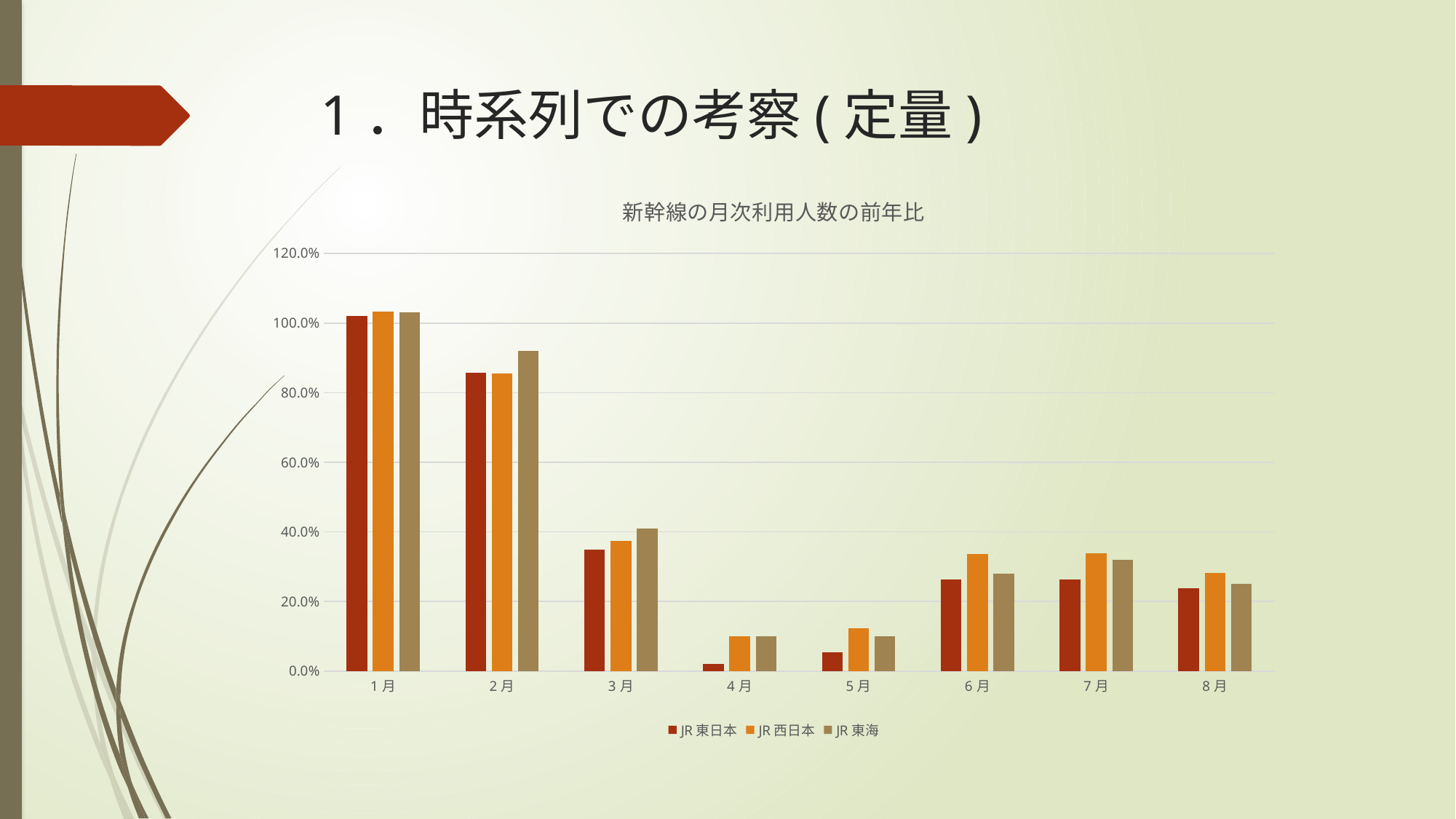
In 2月, which is larger: JR東海 or JR東日本? JR東海 Which month has the lowest value for JR東日本? 4月 Is the value for JR西日本 in 6月 greater or less than 20.0%? greater How many series does the legend list? 3 Is the value for JR東海 in 2月 greater or less than 80.0%? greater Do the values for JR東日本 rise or fall from 1月 to 4月? fall What kind of chart is shown on the slide? bar chart Is the value for JR東日本 in 4月 greater or less than 20.0%? less What is the title of the chart? 新幹線の月次利用人数の前年比 How many months are shown on the x axis? 8 Which month has the highest value for JR東日本? 1月 In 7月, which is larger: JR西日本 or JR東日本? JR西日本